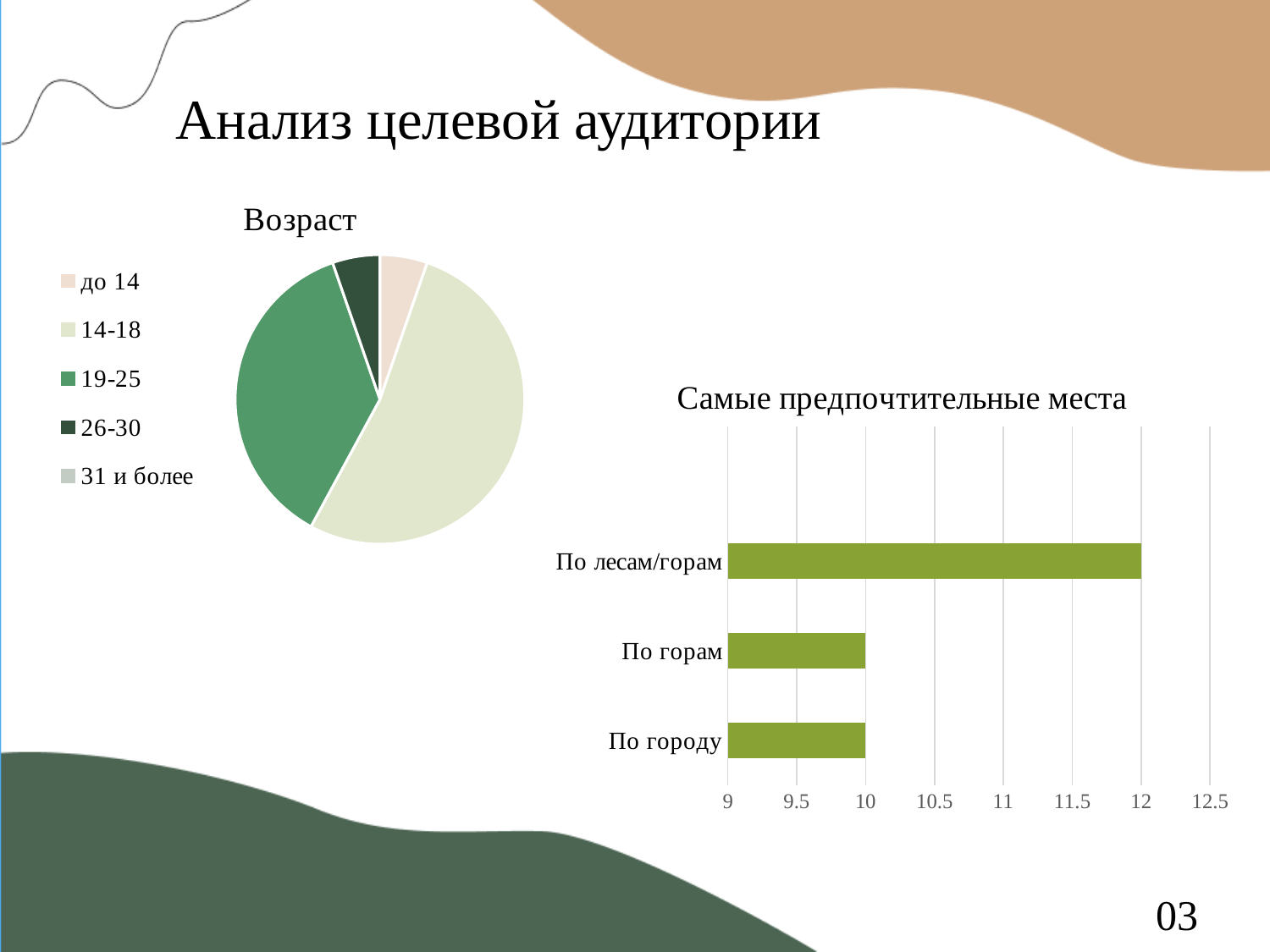
On the chart titled "Самые предпочтительные места", which is larger: the value for "По лесам/горам" or the value for "По городу"? По лесам/горам How many entries does the legend of the chart titled "Возраст" list? 5 What kind of chart is the chart titled "Самые предпочтительные места"? bar chart On the chart titled "Самые предпочтительные места", what is the value for "По лесам/горам"? 12 On the chart titled "Самые предпочтительные места", what is the difference between the values for "По лесам/горам" and "По горам"? 2 What kind of chart is the chart titled "Возраст"? pie chart How many categories are shown on the chart titled "Самые предпочтительные места"? 3 On the chart titled "Самые предпочтительные места", what is the value for "По городу"? 10 On the chart titled "Самые предпочтительные места", which category has the highest value? По лесам/горам On the chart titled "Самые предпочтительные места", is the value for "По лесам/горам" greater or less than 11? greater On the chart titled "Самые предпочтительные места", what is the value for "По горам"? 10 On the chart titled "Возраст", which age group has the largest slice? 14-18